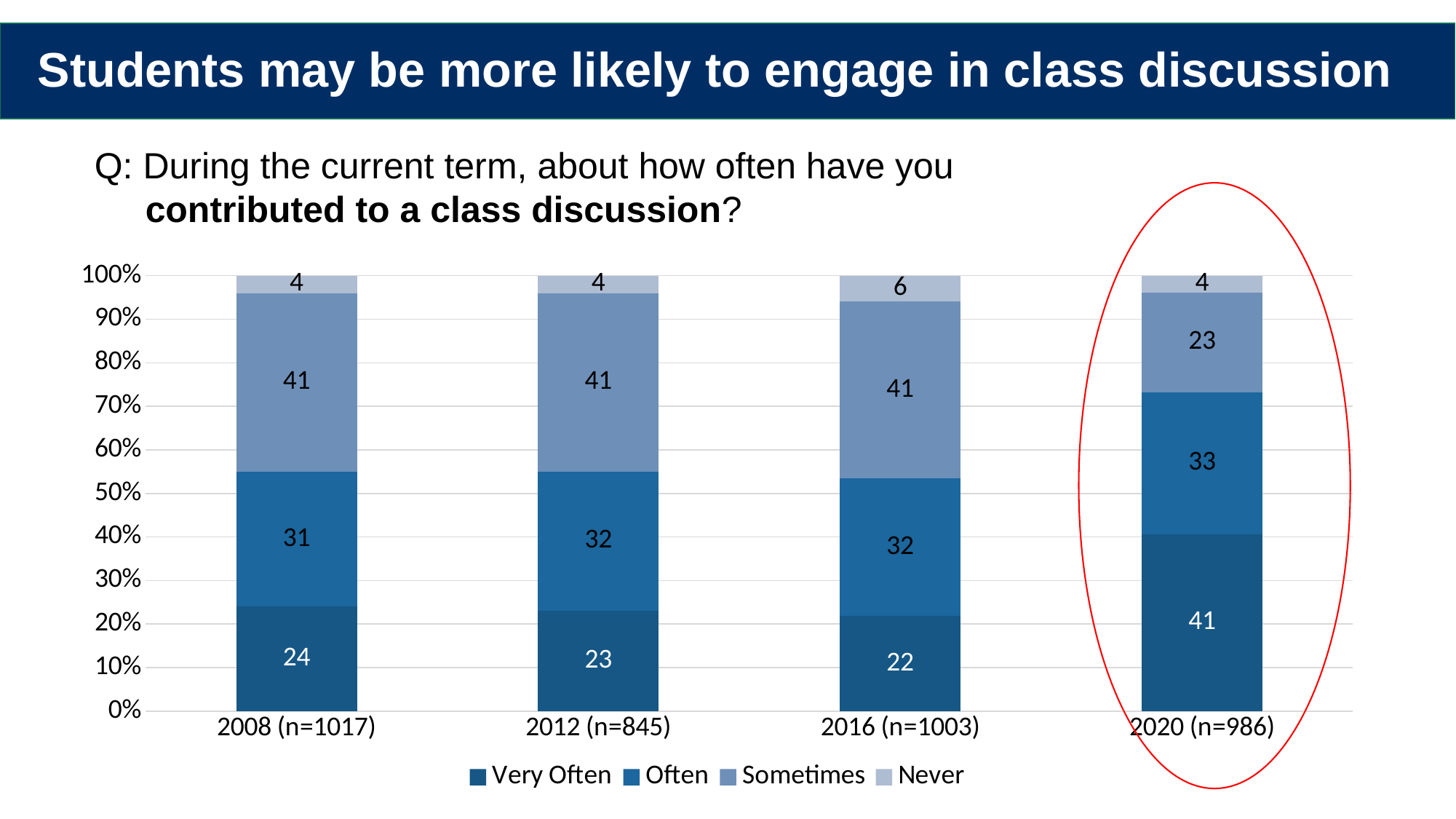
What is the difference between the Very Often values for 2020 (n=986) and 2016 (n=1003)? 19 How many year categories are shown on the x axis? 4 What is the value for Sometimes in 2016 (n=1003)? 41 What kind of chart is shown on the slide? Stacked bar chart What is the value for Often in 2008 (n=1017)? 31 What is the value for Never in 2016 (n=1003)? 6 Does the Very Often value rise or fall from 2016 (n=1003) to 2020 (n=986)? Rise What is the value for Very Often in 2020 (n=986)? 41 Which is larger: the Often value in 2020 (n=986) or the Often value in 2012 (n=845)? 2020 (n=986) Which year has the lowest value for Sometimes? 2020 (n=986) How many series does the legend list? 4 Which year has the highest value for Very Often? 2020 (n=986)